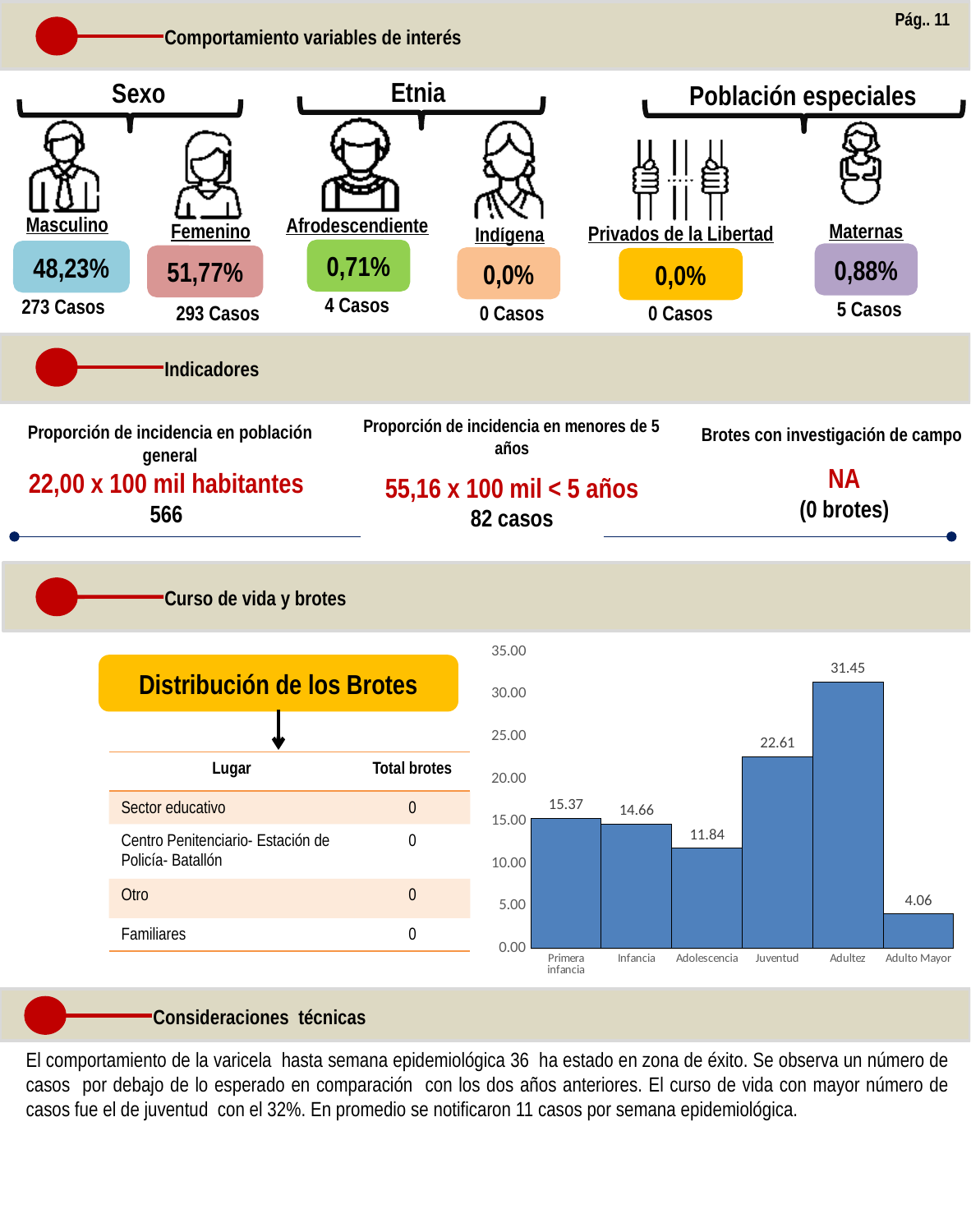
How many categories are shown on the x axis of the bar chart? 6 What is the value for Juventud in the bar chart? 22.61 Which is larger in the bar chart, Infancia or Adolescencia? Infancia What is the value for Primera infancia in the bar chart? 15.37 What is the value for Adultez in the bar chart? 31.45 What is the difference between the values for Adultez and Juventud in the bar chart? 8.84 What is the highest value shown on the y axis of the bar chart? 35.00 What kind of chart is shown in the Curso de vida y brotes section? bar chart Which category has the highest value in the bar chart? Adultez Which category has the lowest value in the bar chart? Adulto Mayor What is the value for Adolescencia in the bar chart? 11.84 Is the value for Adulto Mayor in the bar chart greater or less than 5.00? less